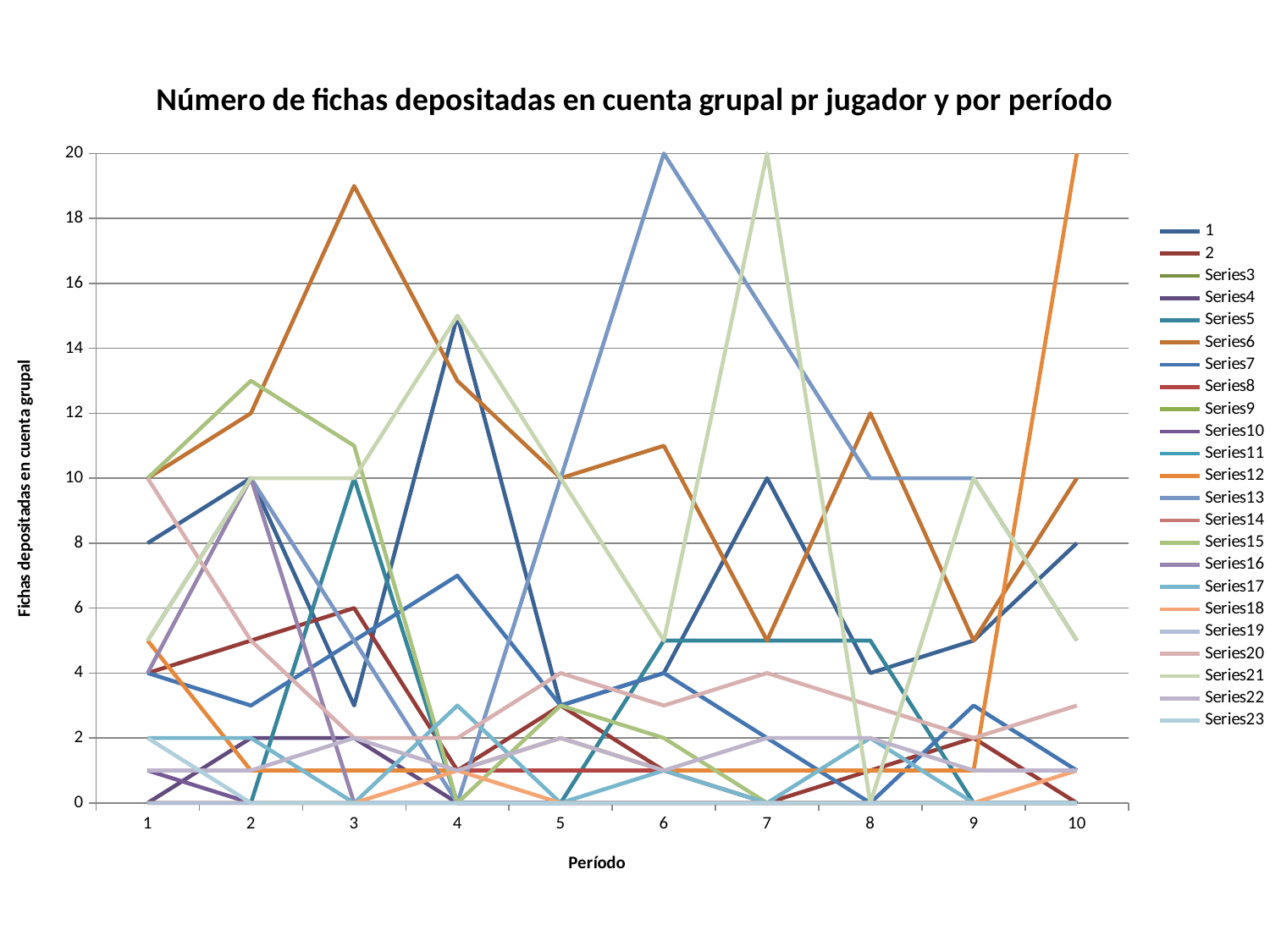
What is the title of the chart? Número de fichas depositadas en cuenta grupal pr jugador y por período What is the value for series 1 at period 1? 8 Is the value for Series21 at period 7 greater or less than 18? greater At which period does Series13 reach its highest value? 6 What is the value for Series13 at period 6? 20 How many series does the legend list? 23 What is the value for Series13 at period 8? 10 Is the value for Series6 at period 3 greater or less than 18? greater How many periods are shown along the x axis? 10 Which series has the highest value at period 6? Series13 What is the label of the y axis? Fichas depositadas en cuenta grupal What kind of chart is shown on the slide? line chart